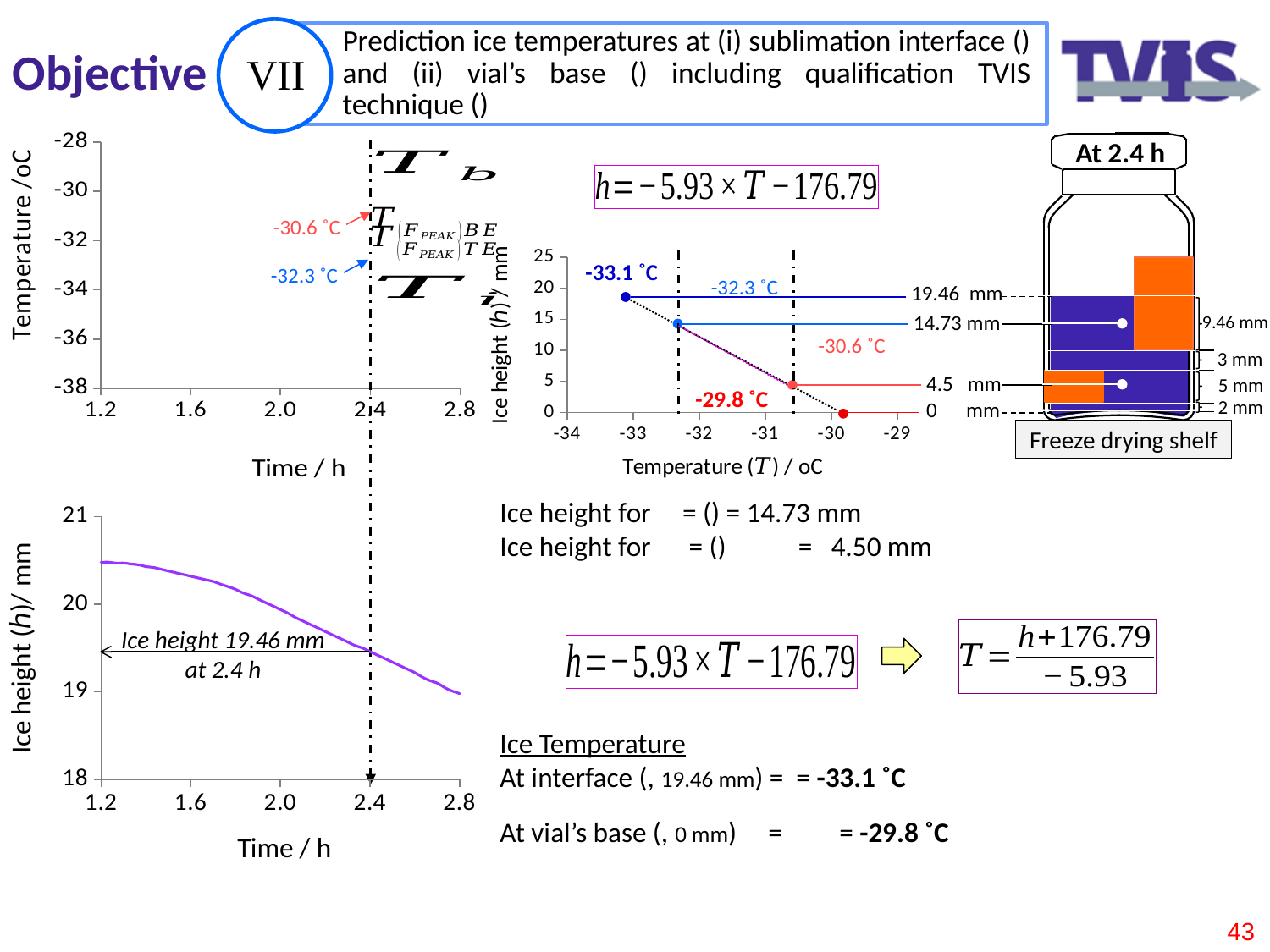
In the middle chart (Ice height vs Temperature), what is the ice height at -30.6 °C? 4.5 mm In the middle chart (Ice height vs Temperature), what temperature corresponds to an ice height of 19.46 mm? -33.1 °C In the bottom-left chart (Ice height vs Time), is the ice height at 1.2 h greater or less than 20 mm? greater In the bottom-left chart (Ice height vs Time), does the ice height rise or fall as time increases from 1.2 h to 2.8 h? fall In the bottom-left chart (Ice height vs Time), what ice height is annotated at 2.4 h? 19.46 mm In the middle chart (Ice height vs Temperature), what is the ice height at -32.3 °C? 14.73 mm In the middle chart (Ice height vs Temperature), how many data points are plotted? 4 In the top-left chart (Temperature vs Time), what temperature is labelled in red at 2.4 h? -30.6 °C In the middle chart (Ice height vs Temperature), what is the difference between the ice heights at -32.3 °C and -30.6 °C? 10.23 mm What kind of chart is the bottom-left chart of ice height against time? line chart In the bottom-left chart (Ice height vs Time), is the ice height at 2.8 h greater or less than 19.5 mm? less In the middle chart (Ice height vs Temperature), what temperature corresponds to an ice height of 0 mm? -29.8 °C